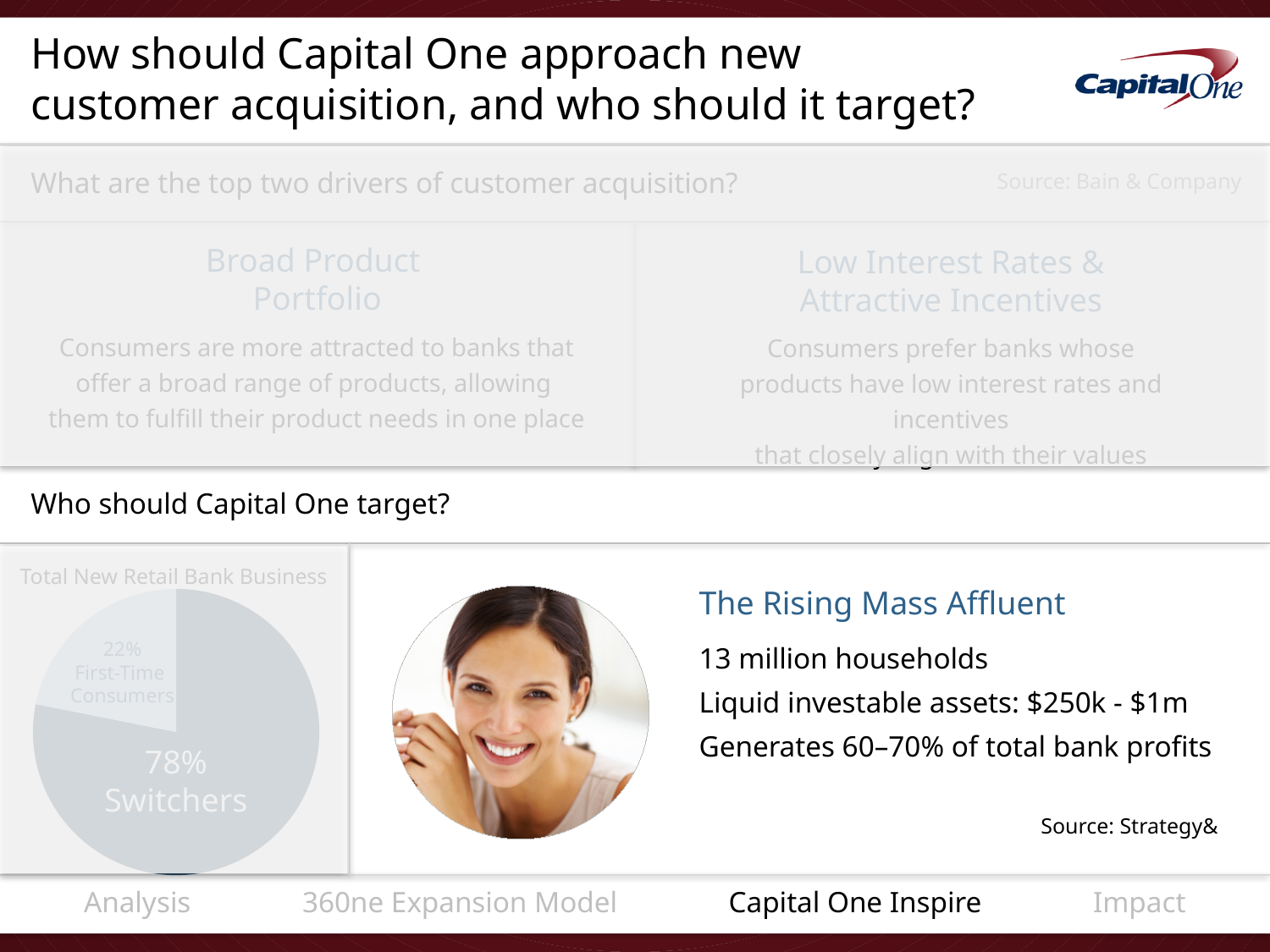
What do the two slices of the pie chart add up to? 100% What share of total new retail bank business comes from Switchers? 78% Which slice of the pie chart is the smallest? First-Time Consumers Which is larger in the pie chart: Switchers or First-Time Consumers? Switchers What is the title of the pie chart? Total New Retail Bank Business How many slices does the pie chart have? 2 Is the share for First-Time Consumers greater or less than 50%? less What kind of chart is shown under "Total New Retail Bank Business"? Pie chart What share of total new retail bank business comes from First-Time Consumers? 22% By how many percentage points does the Switchers share exceed the First-Time Consumers share? 56 percentage points Which slice of the pie chart is the largest? Switchers